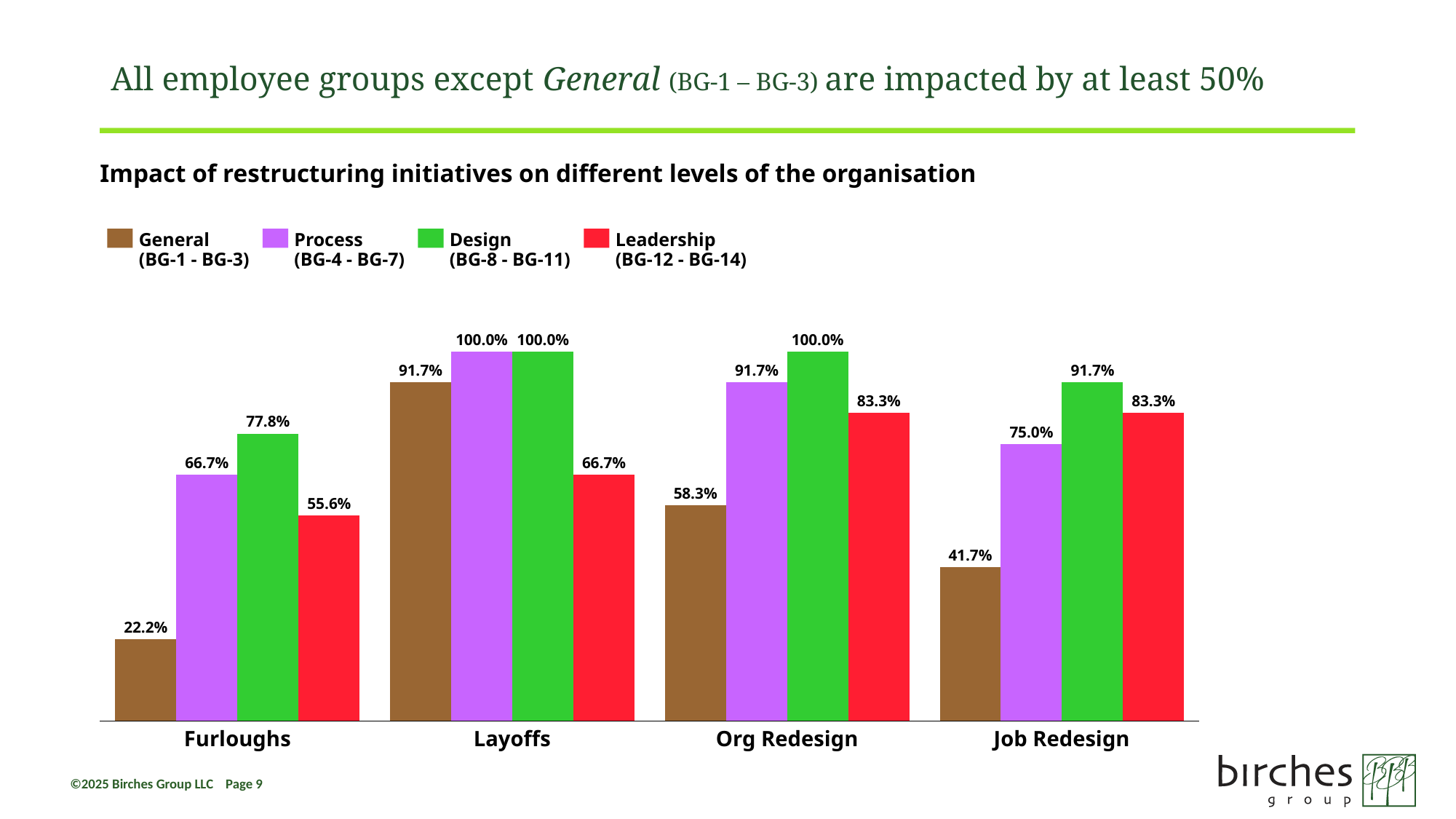
What is the value for Leadership (BG-12 - BG-14) in the Layoffs category? 66.7% What kind of chart is shown on the slide? Bar chart How many categories are shown on the x axis? 4 Which employee group has the highest value in the Org Redesign category? Design (BG-8 - BG-11) Which employee group has the lowest value in the Furloughs category? General (BG-1 - BG-3) What is the value for Process (BG-4 - BG-7) in the Job Redesign category? 75.0% What is the difference between the Design and General values in the Job Redesign category? 50.0% What colour represents the Leadership (BG-12 - BG-14) series? Red Which is larger: the Process value for Furloughs or the Process value for Org Redesign? Org Redesign What is the value for General (BG-1 - BG-3) in the Furloughs category? 22.2% Which category has the highest value for General (BG-1 - BG-3)? Layoffs How many series does the legend list? 4